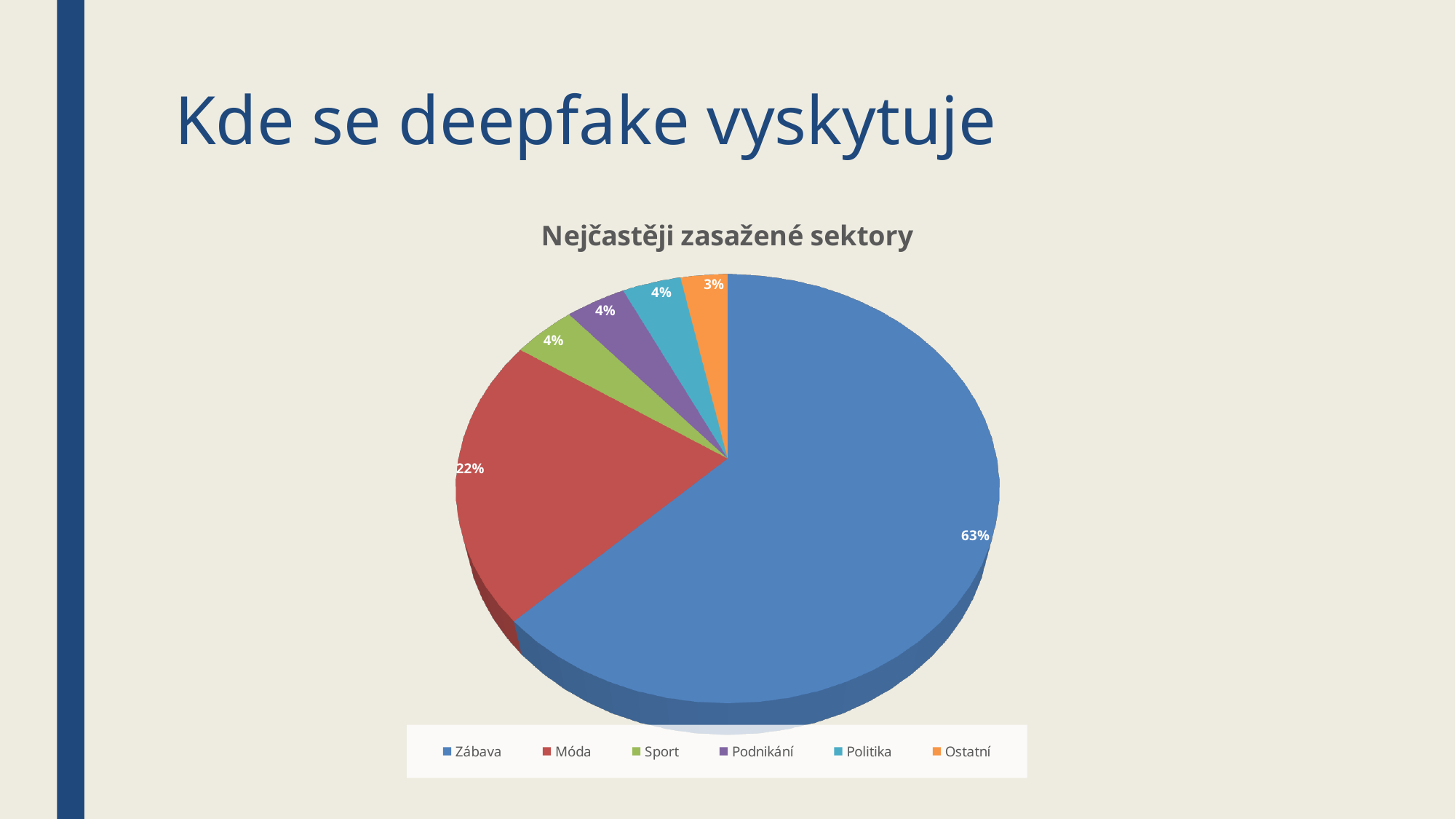
How many categories does the legend list? 6 What type of chart is shown on the slide? Pie chart What colour is the Zábava slice? Blue What is the difference in percentage points between Zábava and Móda? 41 What share of the pie does Ostatní have? 3% What is the title of the chart? Nejčastěji zasažené sektory Which sector has the largest share of the pie? Zábava What share of the pie does Zábava have? 63% Which has a larger share, Móda or Politika? Móda What share of the pie does Móda have? 22% What share of the pie does Sport have? 4% Which sector has the smallest share of the pie? Ostatní